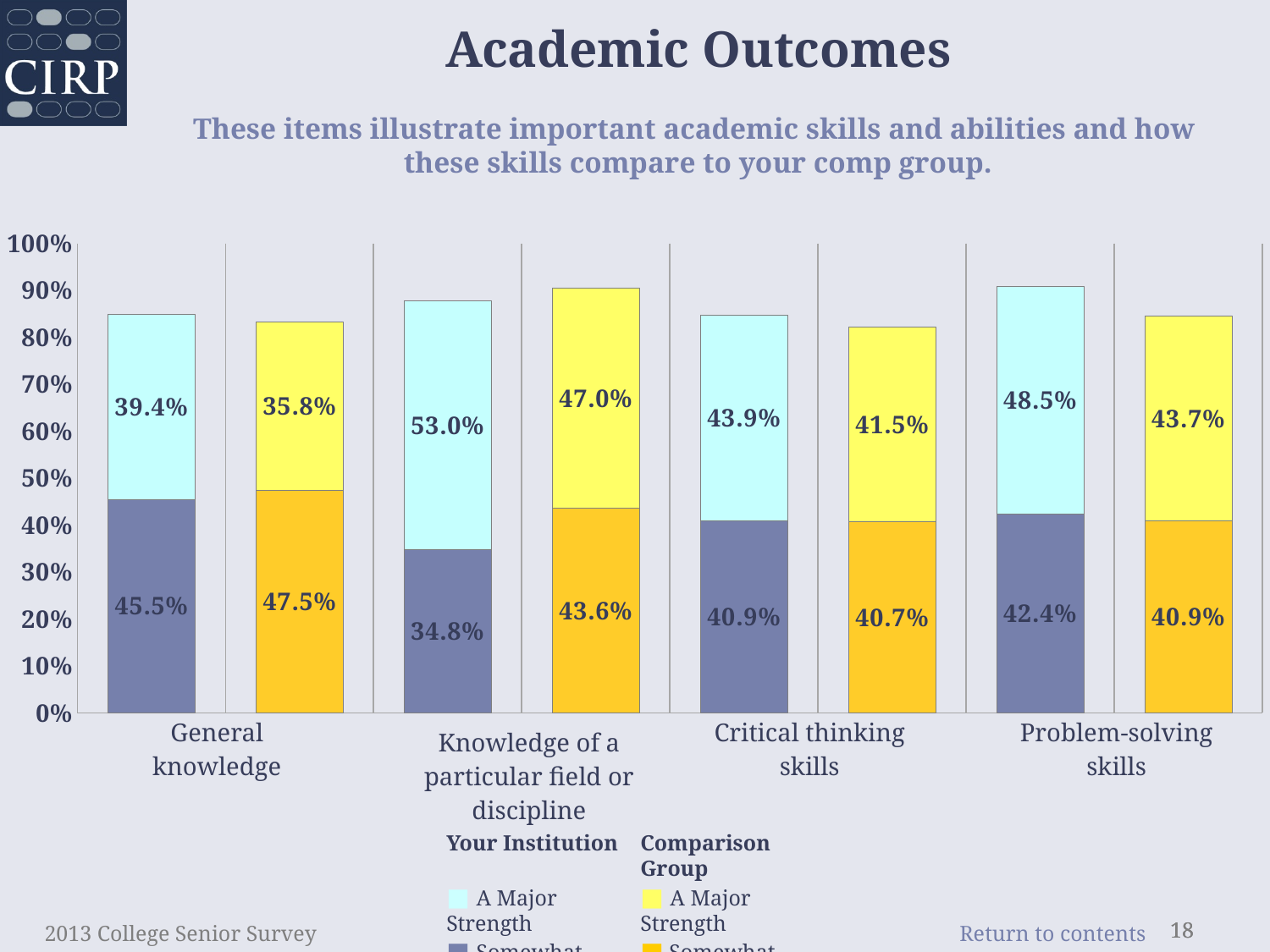
Which category has the highest 'A Major Strength' value for Your Institution? Knowledge of a particular field or discipline What is the difference between the 'A Major Strength' values for Your Institution and the Comparison Group for Problem-solving skills? 4.8% For Critical thinking skills, which is larger: the 'A Major Strength' value for Your Institution or for the Comparison Group? Your Institution What type of chart is shown on the slide? Stacked bar chart What is the total height of the Your Institution stacked bar for Problem-solving skills? 90.9% What is the 'A Major Strength' value for Your Institution for Knowledge of a particular field or discipline? 53.0% How many categories are shown along the x axis? 4 What is the title of the chart slide? Academic Outcomes Which category has the lowest 'A Major Strength' value for the Comparison Group? General knowledge What is the value of the lower (dark blue) segment for Your Institution for General knowledge? 45.5% What is the value of the lower (orange) segment for the Comparison Group for Critical thinking skills? 40.7% What is the 'A Major Strength' value for the Comparison Group for Problem-solving skills? 43.7%